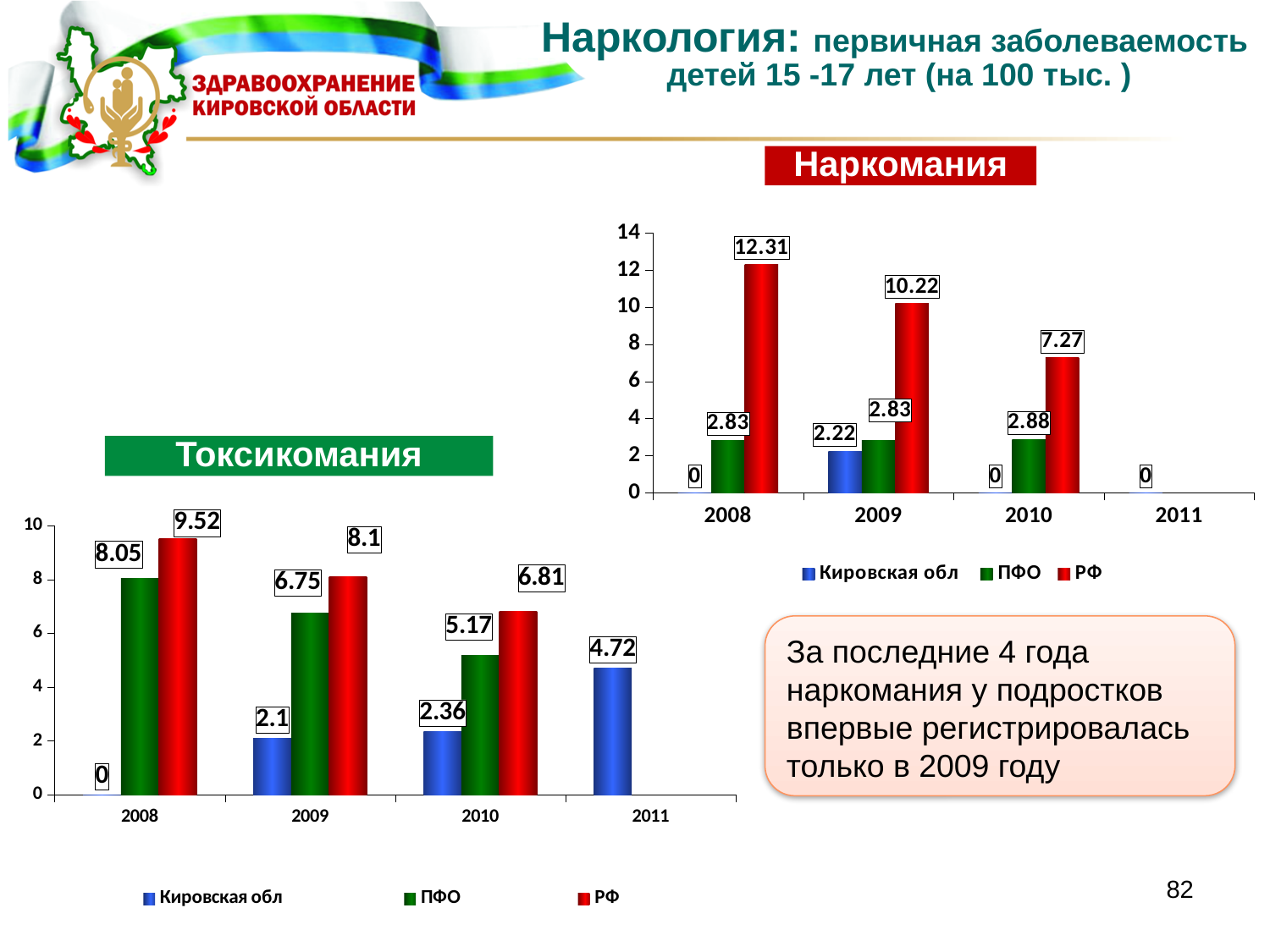
In the "Токсикомания" chart, what is the value for ПФО in 2010? 5.17 In the "Наркомания" chart, does the РФ value rise or fall from 2008 to 2010? fall How many series does the legend of the "Наркомания" chart list? 3 What type of chart is the "Токсикомания" chart? bar chart In the "Наркомания" chart, what is the value for РФ in 2008? 12.31 In the "Токсикомания" chart, which is larger in 2009: the value for ПФО or the value for РФ? РФ In the "Токсикомания" chart, which year has the lowest value for РФ among the years where it is shown? 2010 In the "Токсикомания" chart, what is the value for Кировская обл in 2011? 4.72 In the "Наркомания" chart, which year has the highest value for РФ? 2008 In the "Токсикомания" chart, what is the difference between the РФ and ПФО values in 2008? 1.47 In the "Наркомания" chart, what is the difference between the РФ values for 2008 and 2010? 5.04 In the "Наркомания" chart, what is the value for Кировская обл in 2009? 2.22